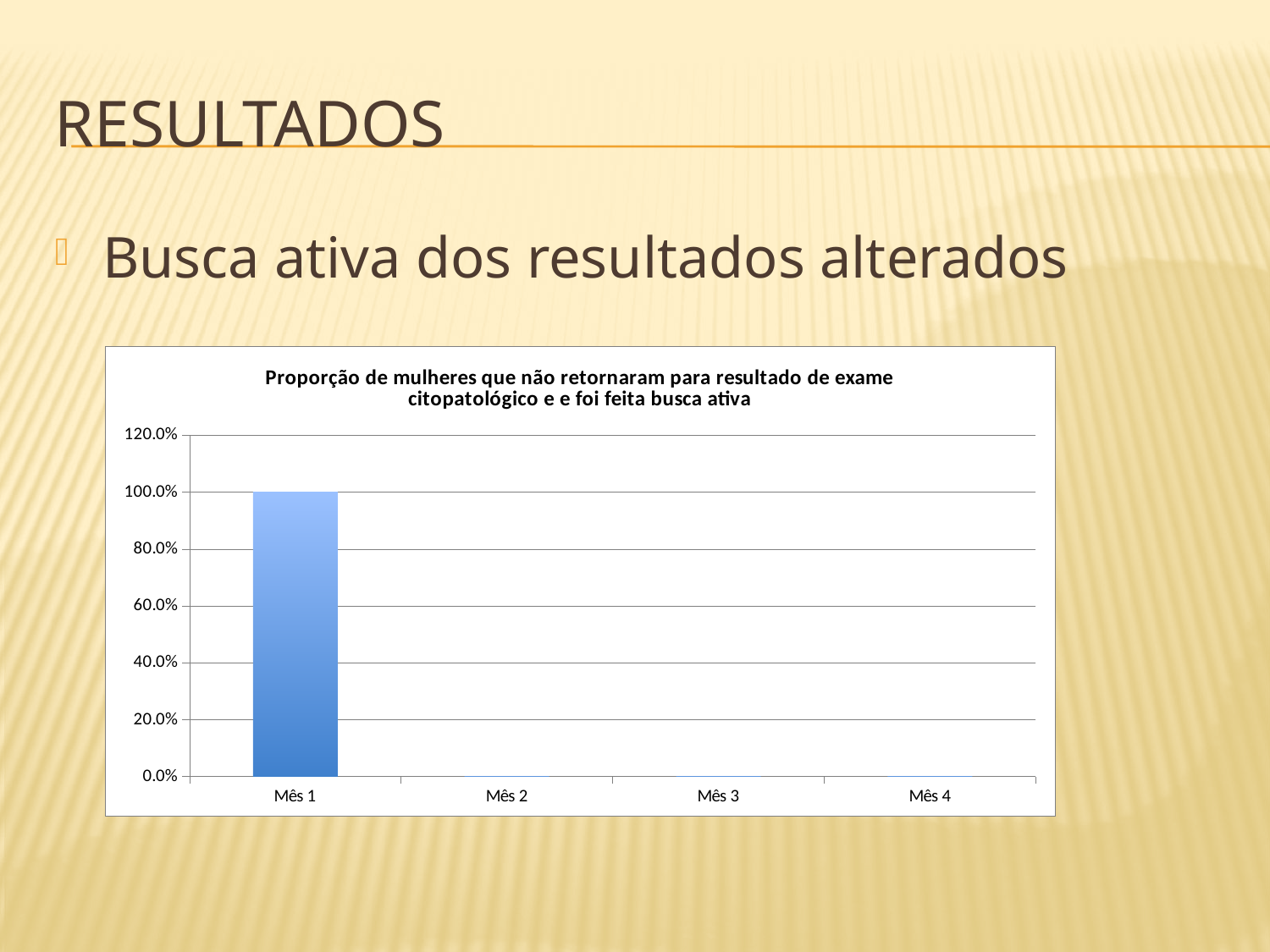
How many categories are shown on the x axis of the chart? 4 Is the value for Mês 1 greater or less than 80.0%? greater How many categories have a visible bar in the chart? 1 What is the highest value shown on the y axis of the chart? 120.0% What is the label of the first category on the x axis? Mês 1 Which category has the highest value in the chart? Mês 1 What kind of chart is shown on the slide? bar chart What is the label of the last category on the x axis? Mês 4 Is the value for Mês 1 greater or less than 120.0%? less What is the value for Mês 1 in the chart? 100.0%